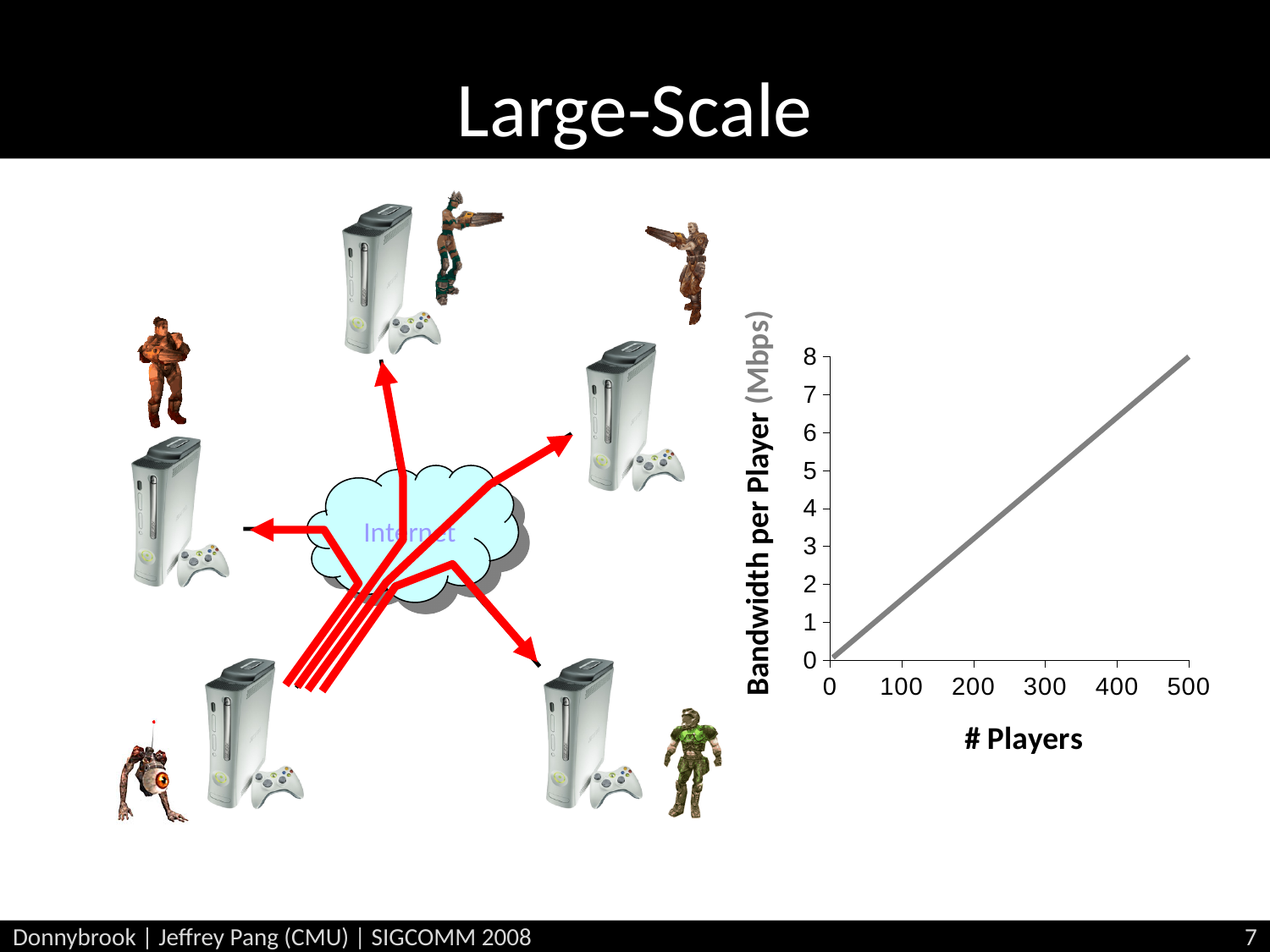
Is the bandwidth per player at 100 players greater or less than 2 Mbps? less What is the bandwidth per player when there are 500 players? 8 Does bandwidth per player rise or fall as the number of players increases? rise Is the bandwidth per player at 400 players greater or less than 6 Mbps? greater Is the bandwidth per player at 200 players greater or less than 4 Mbps? less What is the label of the y axis of the chart? Bandwidth per Player (Mbps) At which number of players is the bandwidth per player highest? 500 Which has the larger bandwidth per player: 100 players or 400 players? 400 players What kind of chart is shown on the slide? line chart What is the label of the x axis of the chart? # Players